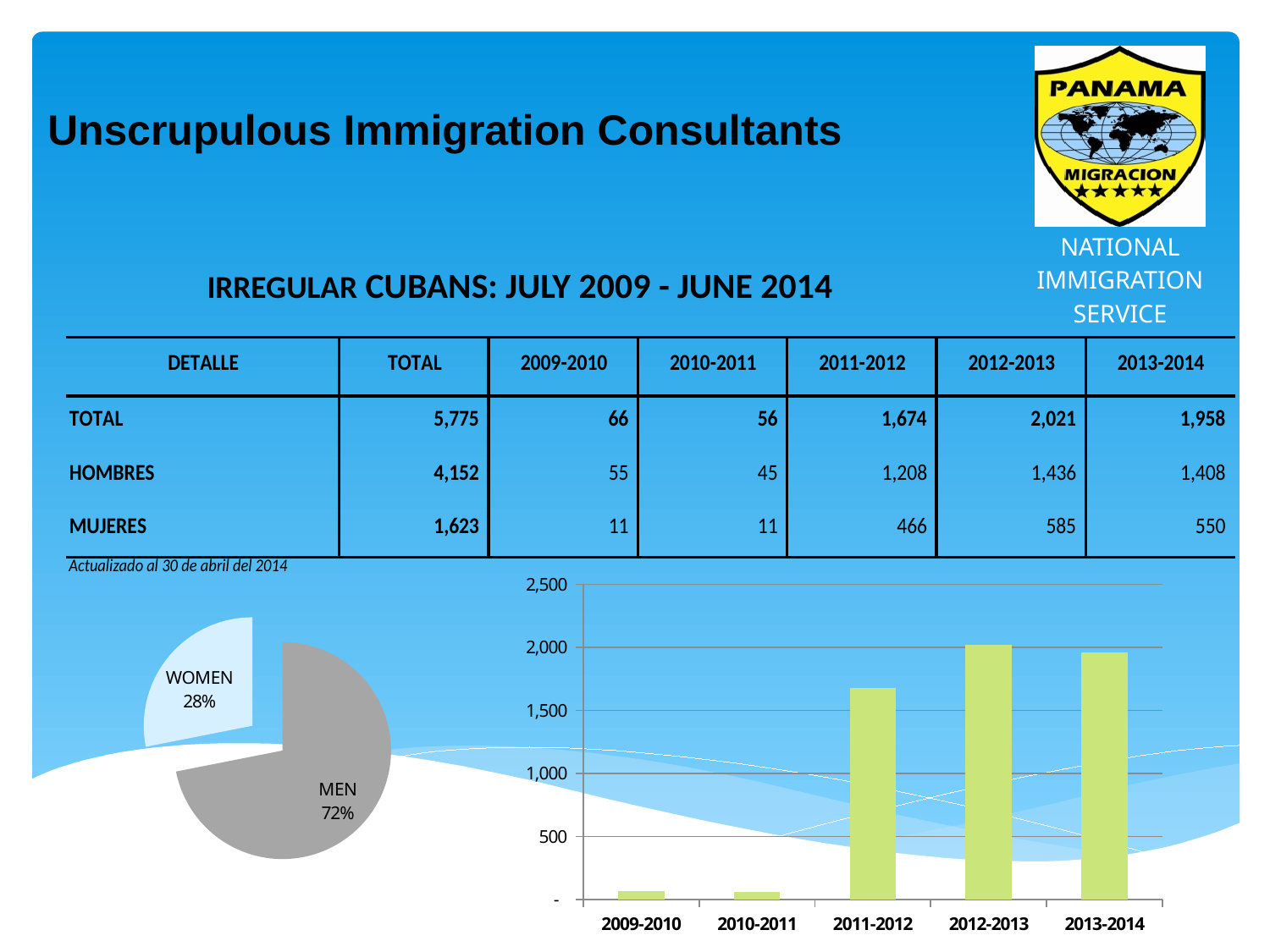
In the pie chart, what share of irregular Cubans are women? 28% In the bar chart, is the value for 2013-2014 greater or less than 2,000? less In the pie chart, what share of irregular Cubans are men? 72% What kind of chart is the chart on the right of the slide? Bar chart In the bar chart, which period has the highest bar? 2012-2013 In the bar chart, which bar is taller, 2011-2012 or 2012-2013? 2012-2013 In the bar chart, is the value for 2009-2010 greater or less than 500? less In the pie chart, which slice is larger, MEN or WOMEN? MEN How many periods are shown on the x axis of the bar chart? 5 In the bar chart, is the value for 2011-2012 greater or less than 1,500? greater How many slices does the pie chart have? 2 In the pie chart, by how many percentage points does the MEN share exceed the WOMEN share? 44 percentage points